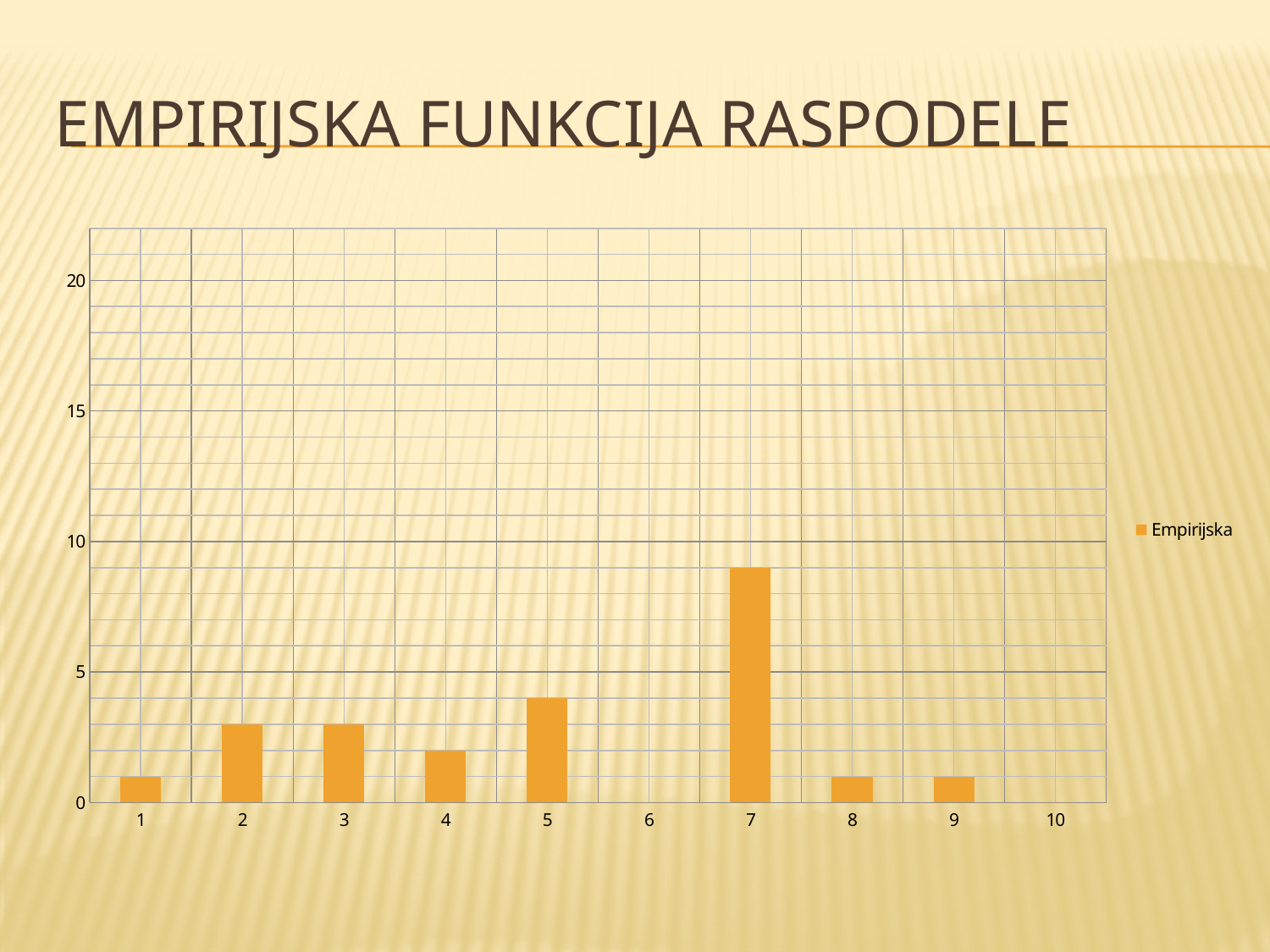
Is the value for category 2 greater or less than 5? less Which has the larger value, category 7 or category 5? 7 What is the name of the series shown in the chart's legend? Empirijska How many series does the chart's legend list? 1 Is the value for category 7 greater or less than 10? less Is the value for category 7 greater or less than 5? greater Which has the larger value, category 5 or category 4? 5 Which category has the highest bar in the chart? 7 What is the value for category 10 in the chart? 0 What is the value for category 6 in the chart? 0 How many categories are shown on the x axis of the chart? 10 What kind of chart is shown on the slide? bar chart